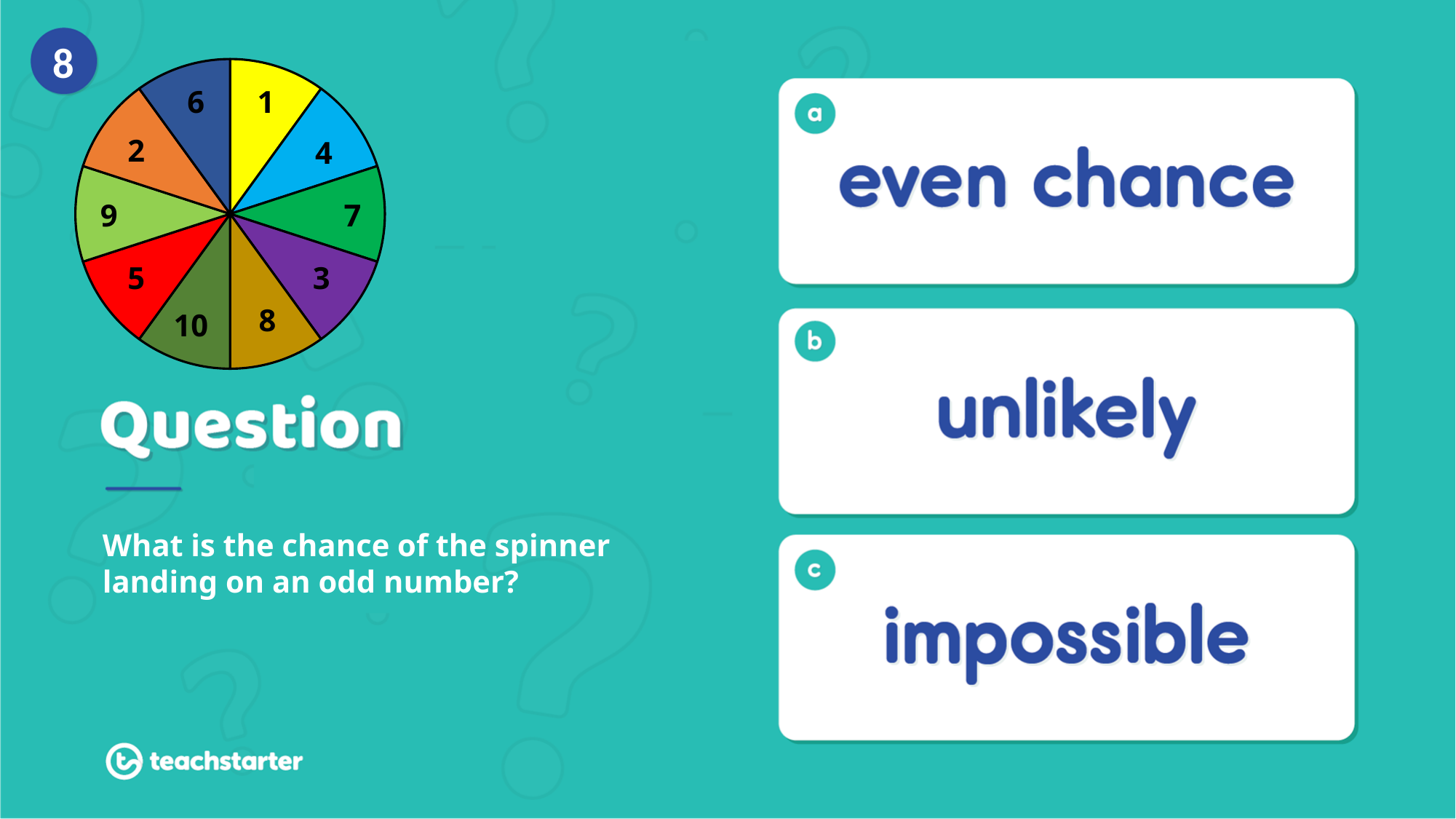
What kind of chart is the spinner on the slide? pie chart How many sections of the spinner are labelled with an even number? 5 What colour is the spinner section labelled 1? yellow How many sections does the spinner have? 10 How many sections of the spinner are labelled with an odd number? 5 What is the smallest number labelled on the spinner? 1 What is the largest number labelled on the spinner? 10 Which number is on the red section of the spinner? 5